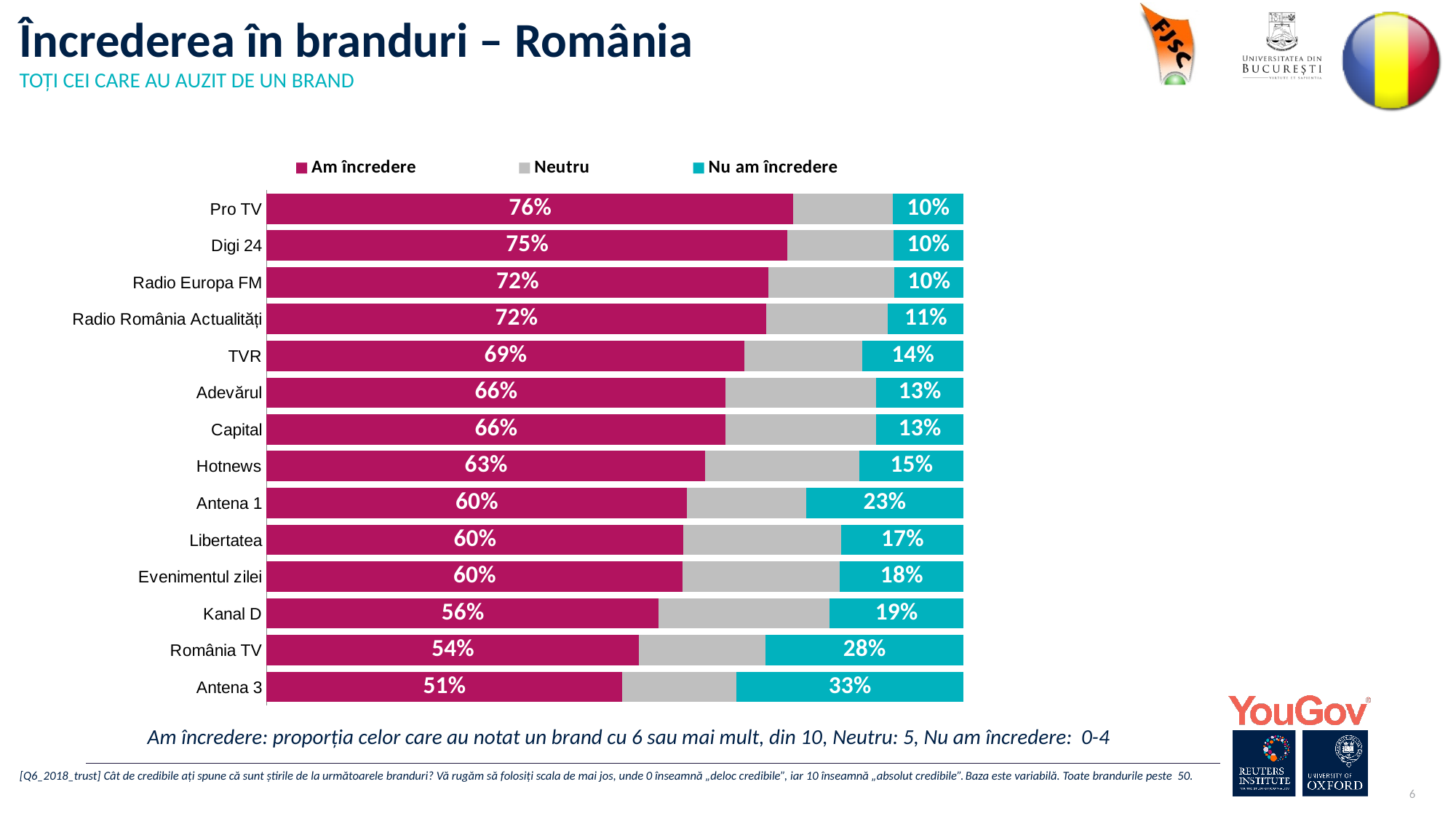
Which brand has the lowest "Am încredere" value? Antena 3 What is the difference between the "Am încredere" values for Pro TV and Antena 3? 25% How many brands are shown in the chart? 14 What is the "Nu am încredere" value for Antena 3? 33% How many series does the legend list? 3 Which brand has the highest "Am încredere" value? Pro TV What is the "Am încredere" value for Pro TV? 76% What is the "Nu am încredere" value for Antena 1? 23% Which brand has the highest "Nu am încredere" value? Antena 3 What is the "Am încredere" value for Kanal D? 56% What kind of chart is shown on the slide? Stacked bar chart Which has a larger "Nu am încredere" value, România TV or Kanal D? România TV